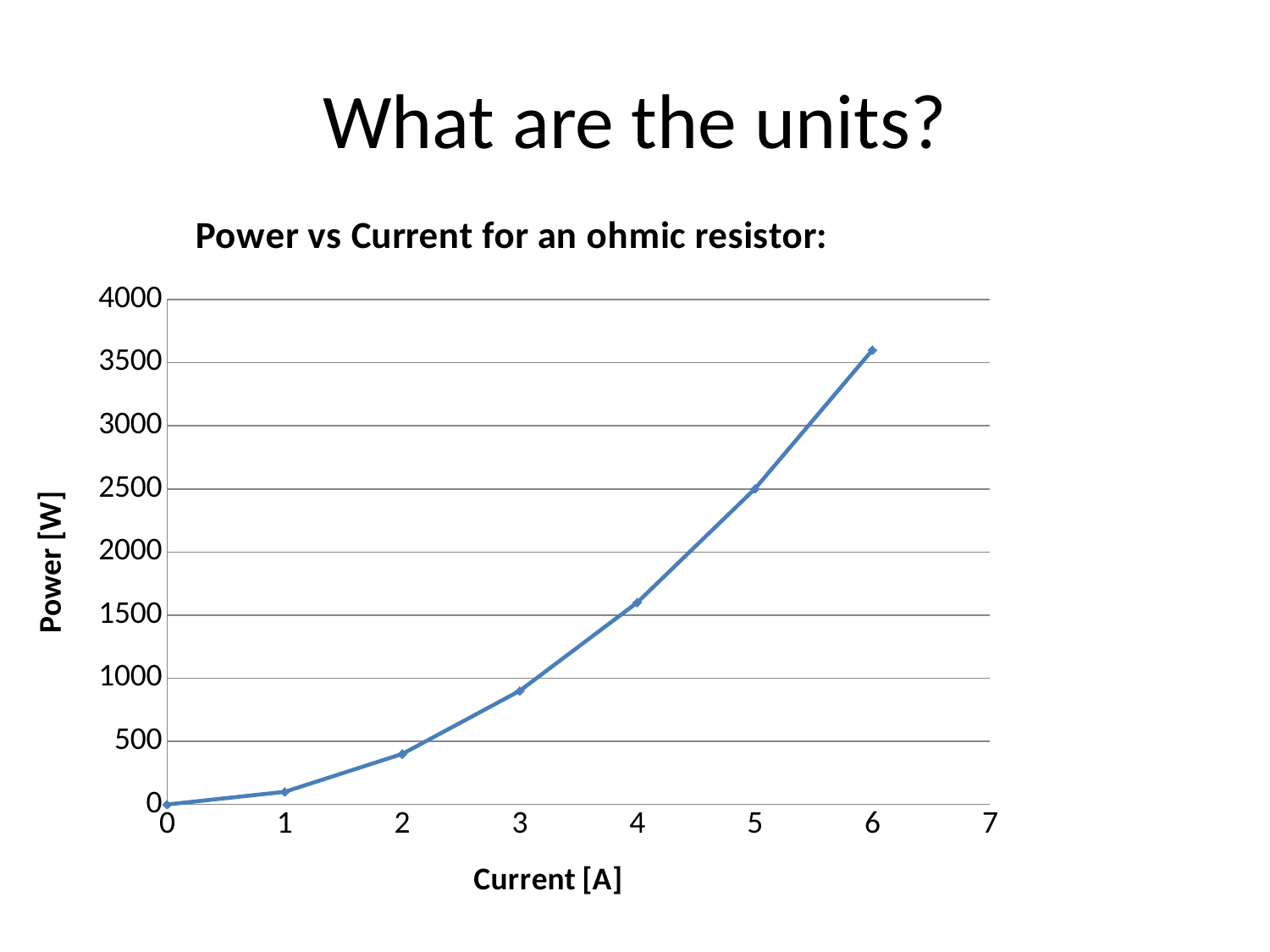
Is the power at a current of 4 A greater or less than 2000? less What is the label of the vertical axis? Power [W] What is the power at a current of 5 A? 2500 Is the power at a current of 2 A greater or less than 500? less Is the power at a current of 3 A greater or less than 500? greater What is the title of the chart? Power vs Current for an ohmic resistor: What is the power at a current of 0 A? 0 Does the power rise or fall as the current increases? rise What kind of chart is shown on the slide? line chart How many data points are plotted on the line? 7 At which current is the power highest? 6